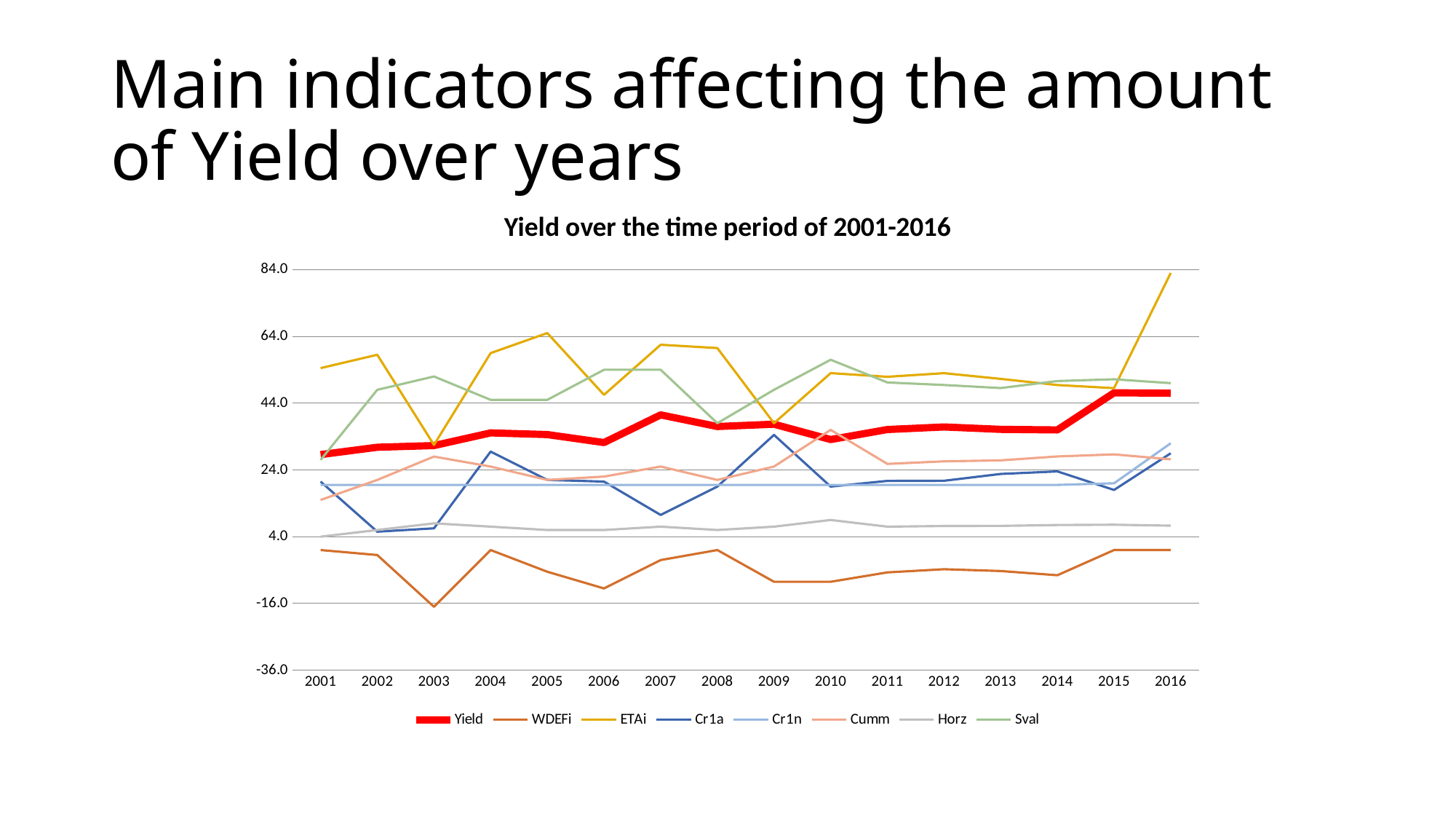
Is the value for ETAi in 2016 greater or less than 64.0? greater Which series has the highest value in 2016? ETAi In 2003, which is larger, ETAi or Sval? Sval How many years are shown along the x axis? 16 In which year does WDEFi reach its lowest value? 2003 Does the Yield line rise or fall from 2014 to 2015? rise What kind of chart is shown on the slide? line chart What is the title of the chart? Yield over the time period of 2001-2016 How many series does the legend list? 8 Which series is drawn with the thick red line? Yield Is the value for Horz in 2010 greater or less than 24.0? less Is the value for WDEFi in 2003 greater or less than 4.0? less